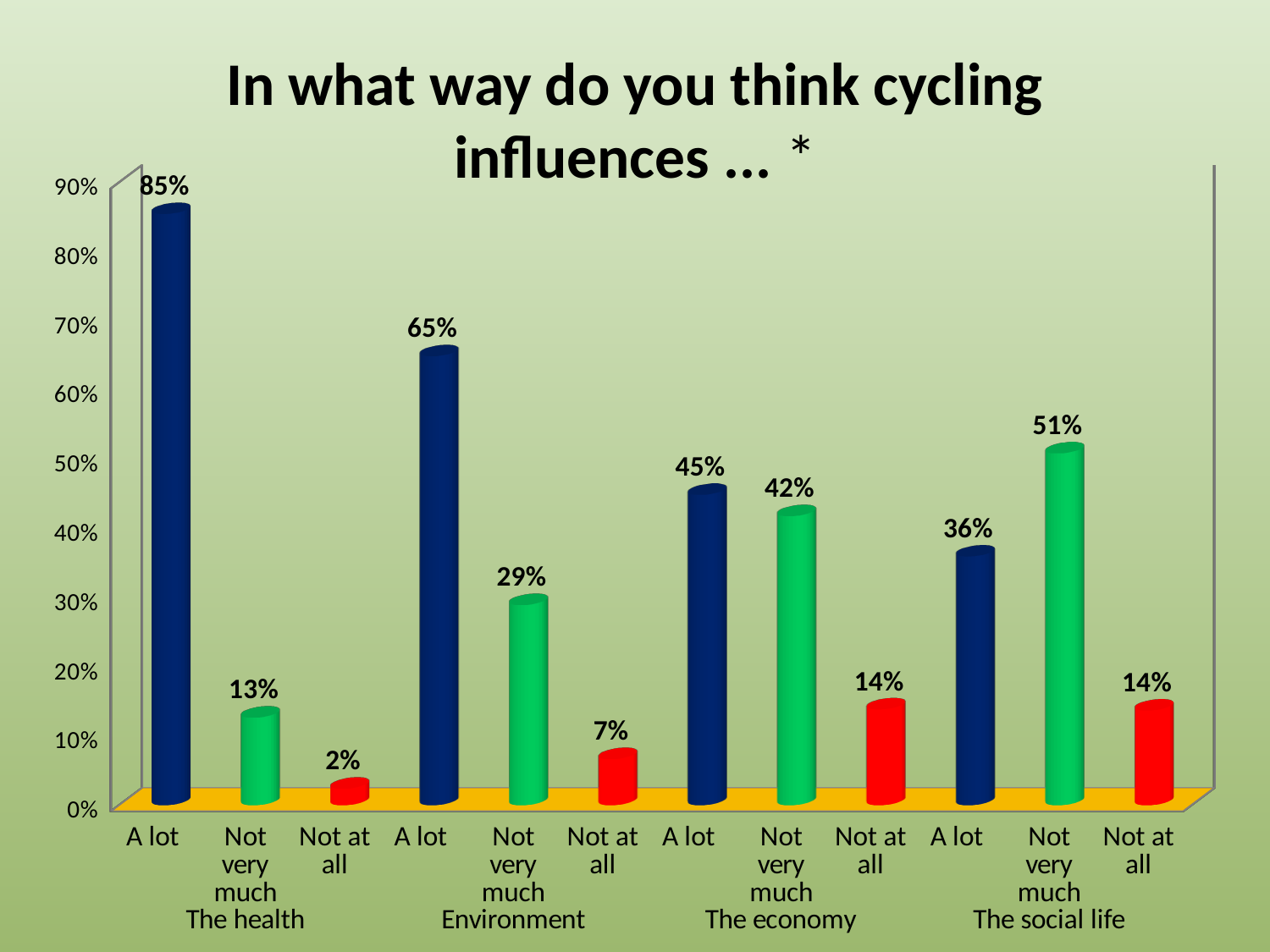
Which bar on the chart has the highest value? A lot, The health (85%) Which bar on the chart has the lowest value? Not at all, The health (2%) What is the difference between the "A lot" values for The health and Environment? 20% Which is larger: "A lot" for The social life or "Not very much" for The social life? Not very much (51%) How many bars are plotted on the chart in total? 12 What percentage of respondents said cycling influences the health "A lot"? 85% What is the title of the chart? In what way do you think cycling influences ... * How many category groups (topics) are shown along the x axis? 4 What is the value for "Not very much" under The economy? 42% What kind of chart is shown on the slide? Bar chart What is the value for "Not very much" under The social life? 51% What is the value for "Not at all" under Environment? 7%